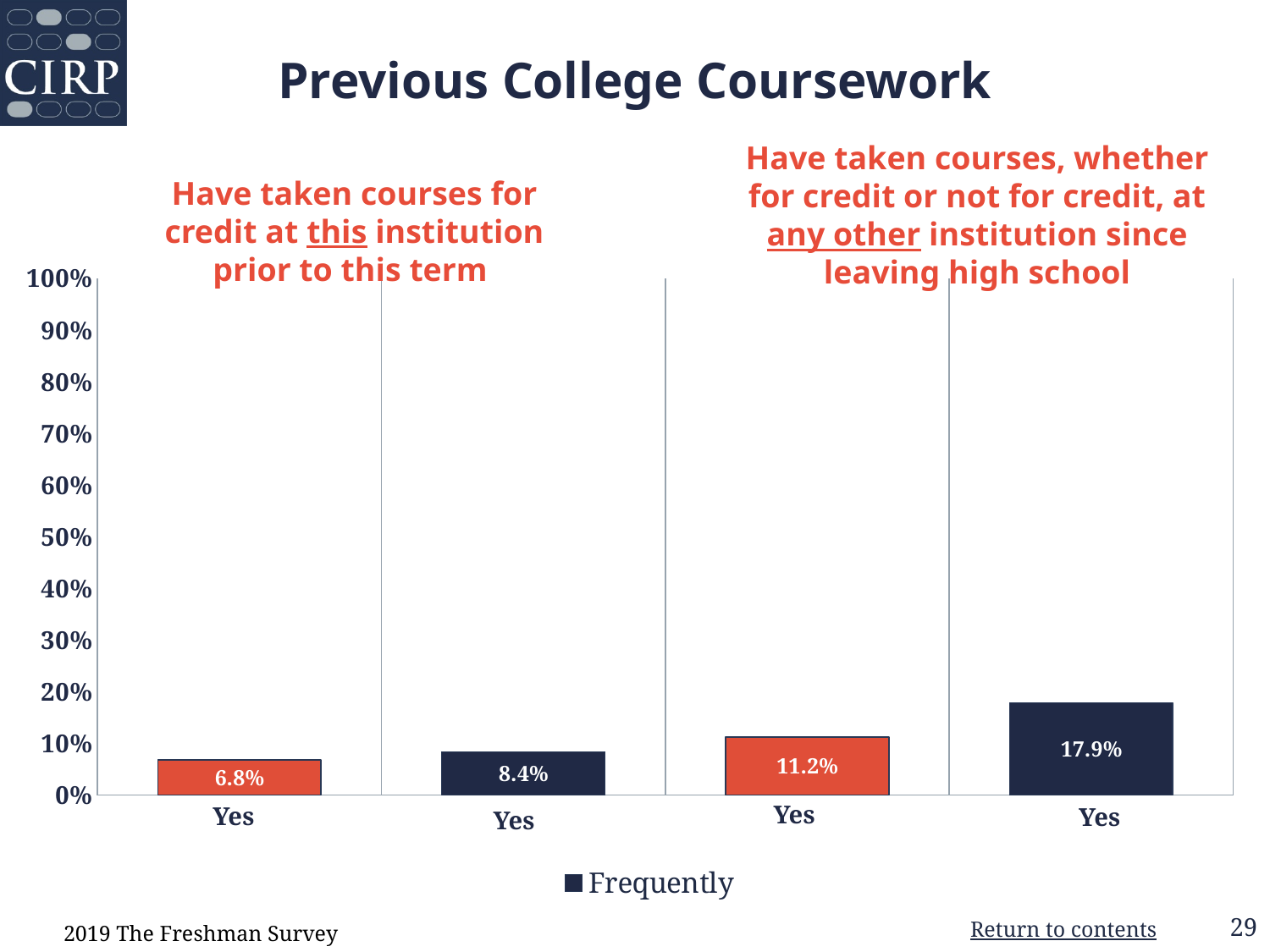
How many bars are plotted on the chart? 4 What is the value of the orange bar under the heading 'Have taken courses for credit at this institution prior to this term'? 6.8% How many entries does the legend list? 1 Which bar has the lowest value on the chart? the leftmost bar (6.8%) What is the value of the dark navy bar under the heading 'Have taken courses for credit at this institution prior to this term'? 8.4% What type of chart is shown on the slide? bar chart Which bar has the highest value on the chart? the rightmost bar (17.9%) What is the difference between the two bars under the heading 'Have taken courses, whether for credit or not for credit, at any other institution since leaving high school'? 6.7% Is the value of the rightmost bar greater or less than 20%? less What is the value of the rightmost bar on the chart? 17.9% What is the title of the slide? Previous College Coursework What is the value of the orange bar under the heading 'Have taken courses, whether for credit or not for credit, at any other institution since leaving high school'? 11.2%